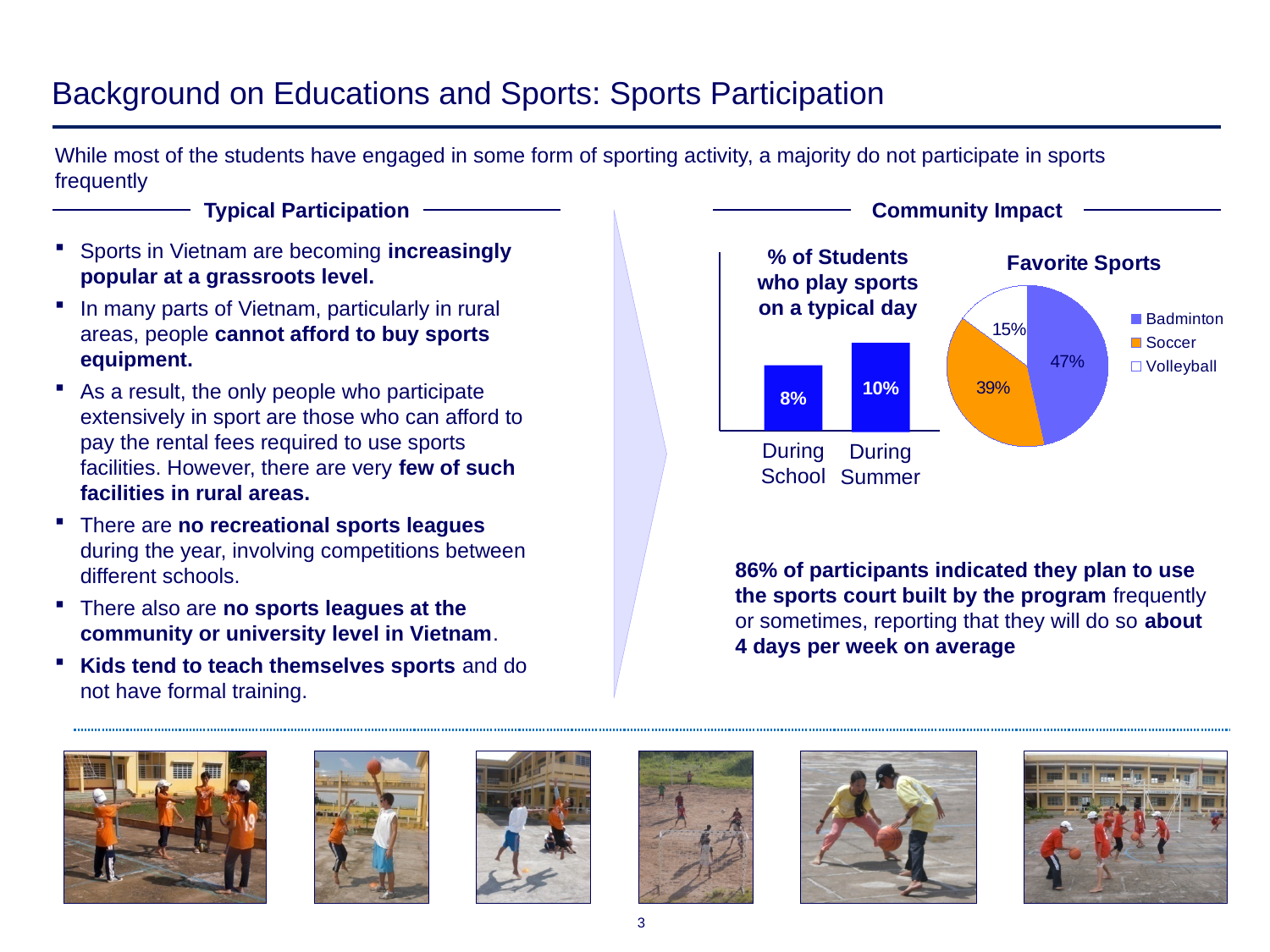
In the 'Favorite Sports' chart, which sport has the smallest slice? Volleyball In the 'Favorite Sports' chart, what share is Volleyball? 15% What kind of chart is the '% of Students who play sports on a typical day' chart? Bar chart In the 'Favorite Sports' chart, what share is Badminton? 47% In the '% of Students who play sports on a typical day' chart, which category has the higher value? During Summer How many entries does the legend of the 'Favorite Sports' chart list? 3 In the '% of Students who play sports on a typical day' chart, what is the value for During School? 8% What kind of chart is the 'Favorite Sports' chart? Pie chart How many categories are shown in the '% of Students who play sports on a typical day' chart? 2 In the '% of Students who play sports on a typical day' chart, what is the difference between During Summer and During School? 2% In the 'Favorite Sports' chart, what share is Soccer? 39% In the '% of Students who play sports on a typical day' chart, what is the value for During Summer? 10%